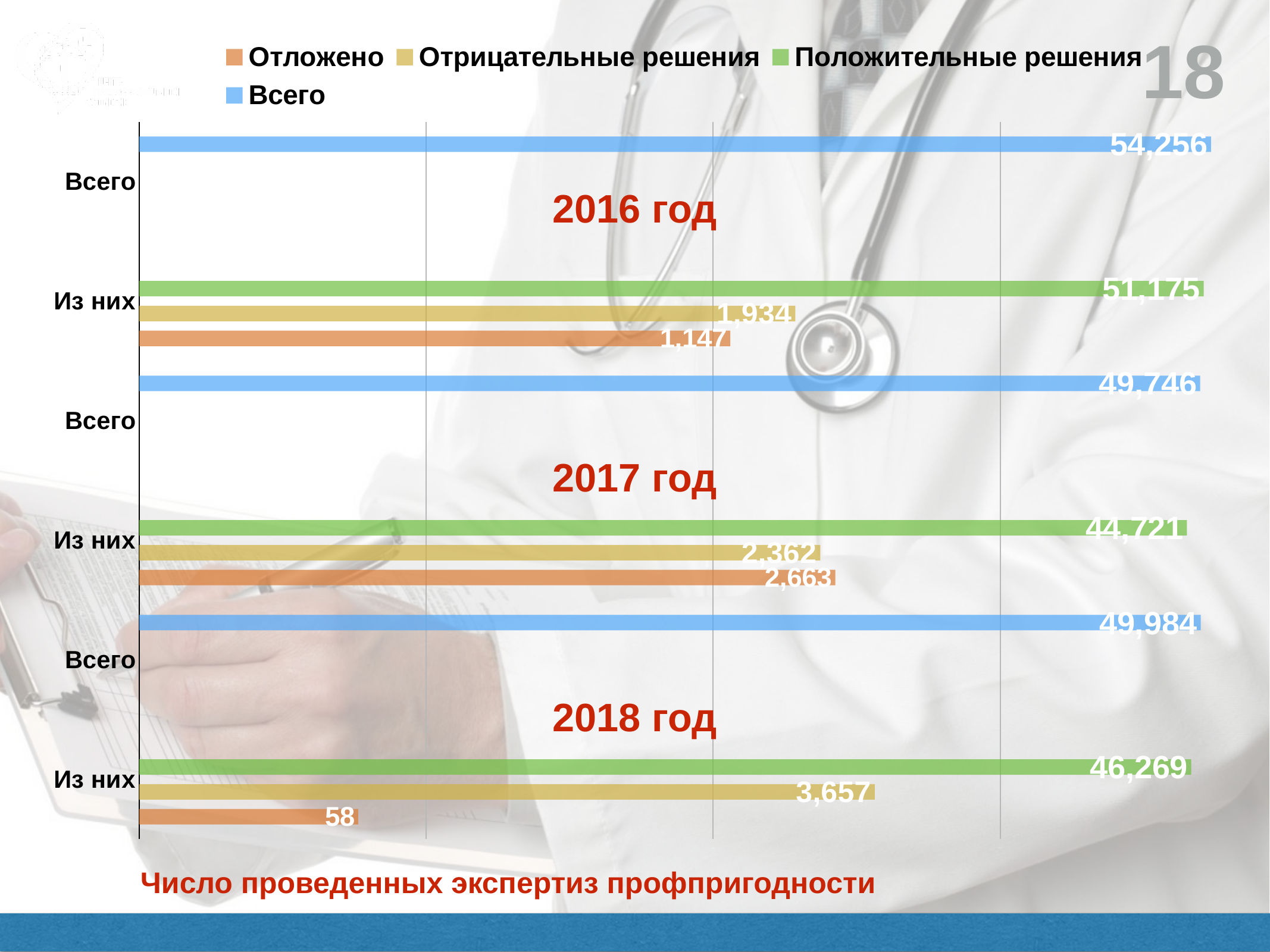
What is the value of Всего for 2018 год? 49,984 What is the title shown below the chart? Число проведенных экспертиз профпригодности What is the value of Отложено for 2017 год? 2,663 In which year is the Отложено value the lowest? 2018 год How many series does the legend list? 4 Do the Отрицательные решения values rise or fall from 2016 год to 2018 год? rise What is the value of Отрицательные решения for 2018 год? 3,657 In 2017 год, what is the difference between Отложено and Отрицательные решения? 301 In 2017 год, which is larger: Отложено or Отрицательные решения? Отложено What is the value of Отложено for 2018 год? 58 What is the value of Положительные решения for 2017 год? 44,721 What kind of chart is shown on the slide? bar chart